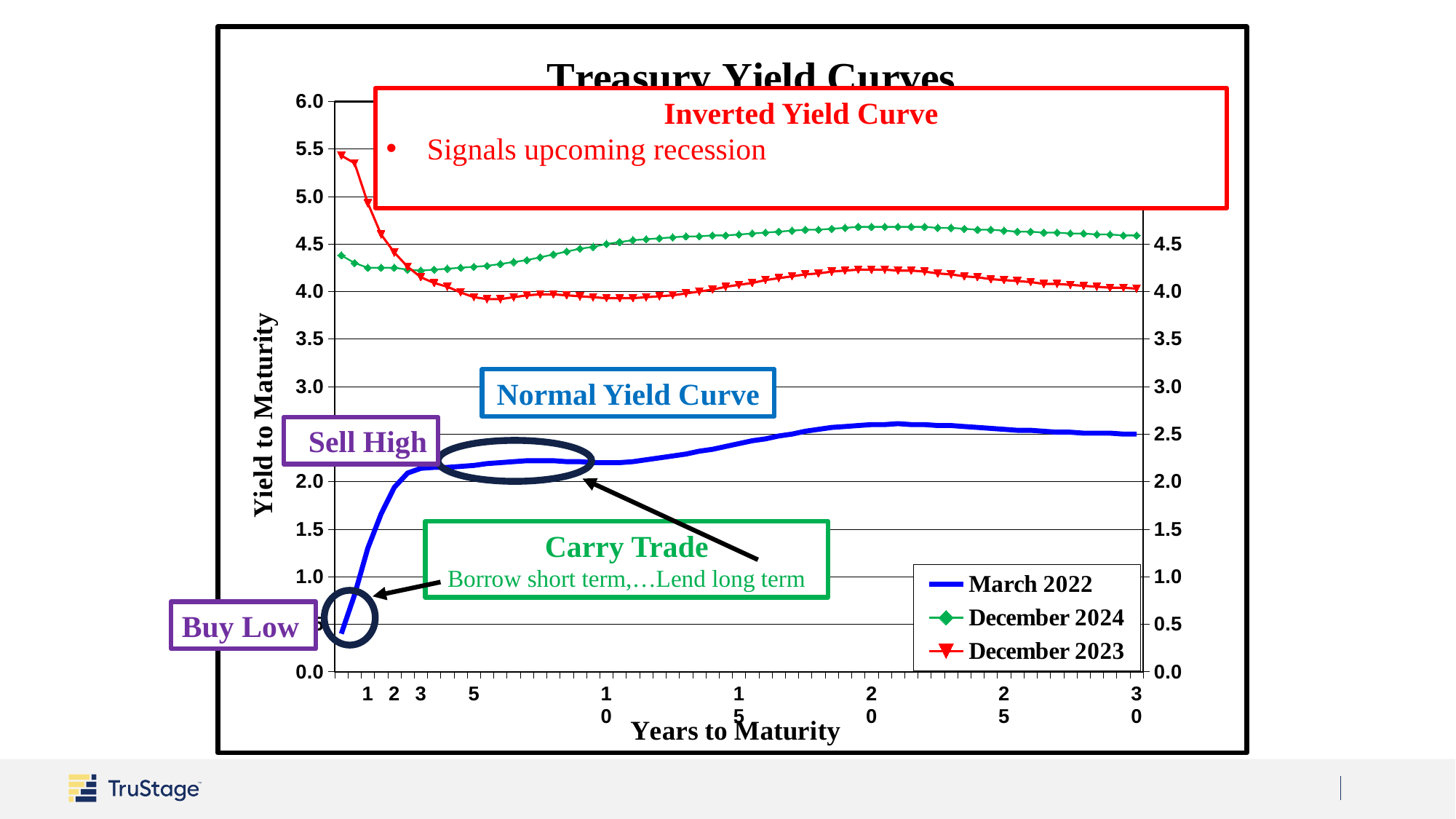
Is the March 2022 yield at 30 years to maturity greater or less than 3.0? less Which series has the lowest yield at 1 year to maturity? March 2022 How many series does the legend of the Treasury Yield Curves chart list? 3 Is the December 2023 yield at the shortest maturity greater or less than 5.0? greater What kind of chart is shown on the slide? line chart What is the title of the chart? Treasury Yield Curves Does the March 2022 yield rise or fall from the shortest maturity to 3 years to maturity? rise At 30 years to maturity, which series has the higher yield: December 2024 or December 2023? December 2024 Which series has the highest yield at 30 years to maturity? December 2024 Is the December 2024 yield at 20 years to maturity greater or less than 4.5? greater Does the December 2023 yield rise or fall from the shortest maturity to 5 years to maturity? fall What is the label of the vertical axis of the chart? Yield to Maturity